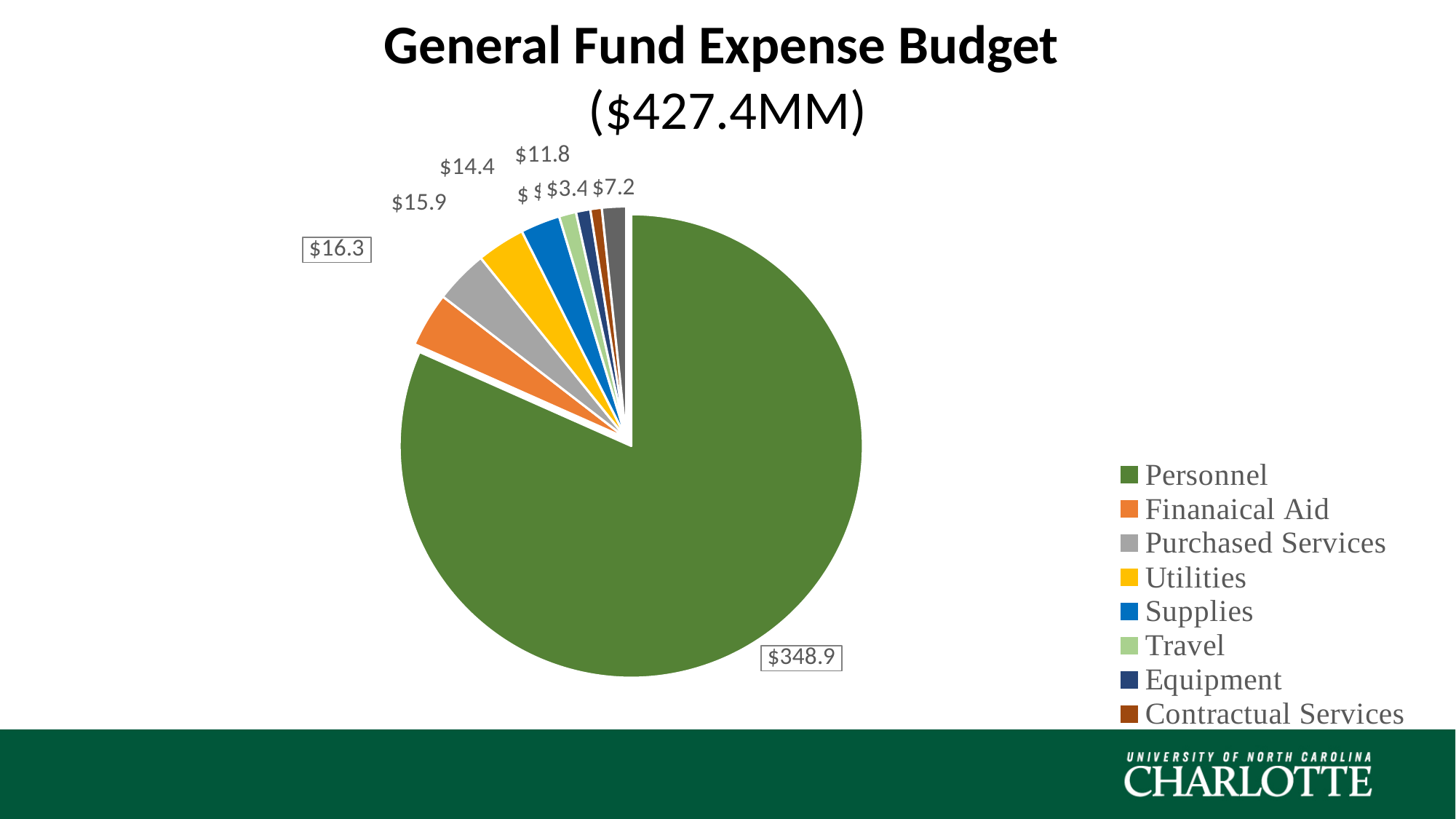
What is the value of the Purchased Services slice? $15.9 What type of chart is shown on the slide? Pie chart What is the value of the Supplies slice? $11.8 What is the difference between the Finanaical Aid value and the Purchased Services value? $0.4 Which category has the largest slice of the pie? Personnel What colour is the Personnel slice? Green What is the title of the chart? General Fund Expense Budget ($427.4MM) What is the value of the Finanaical Aid slice? $16.3 What is the value of the Personnel slice? $348.9 How many categories are listed in the legend? 8 Which is larger, the Finanaical Aid slice or the Utilities slice? Finanaical Aid What is the value of the Utilities slice? $14.4